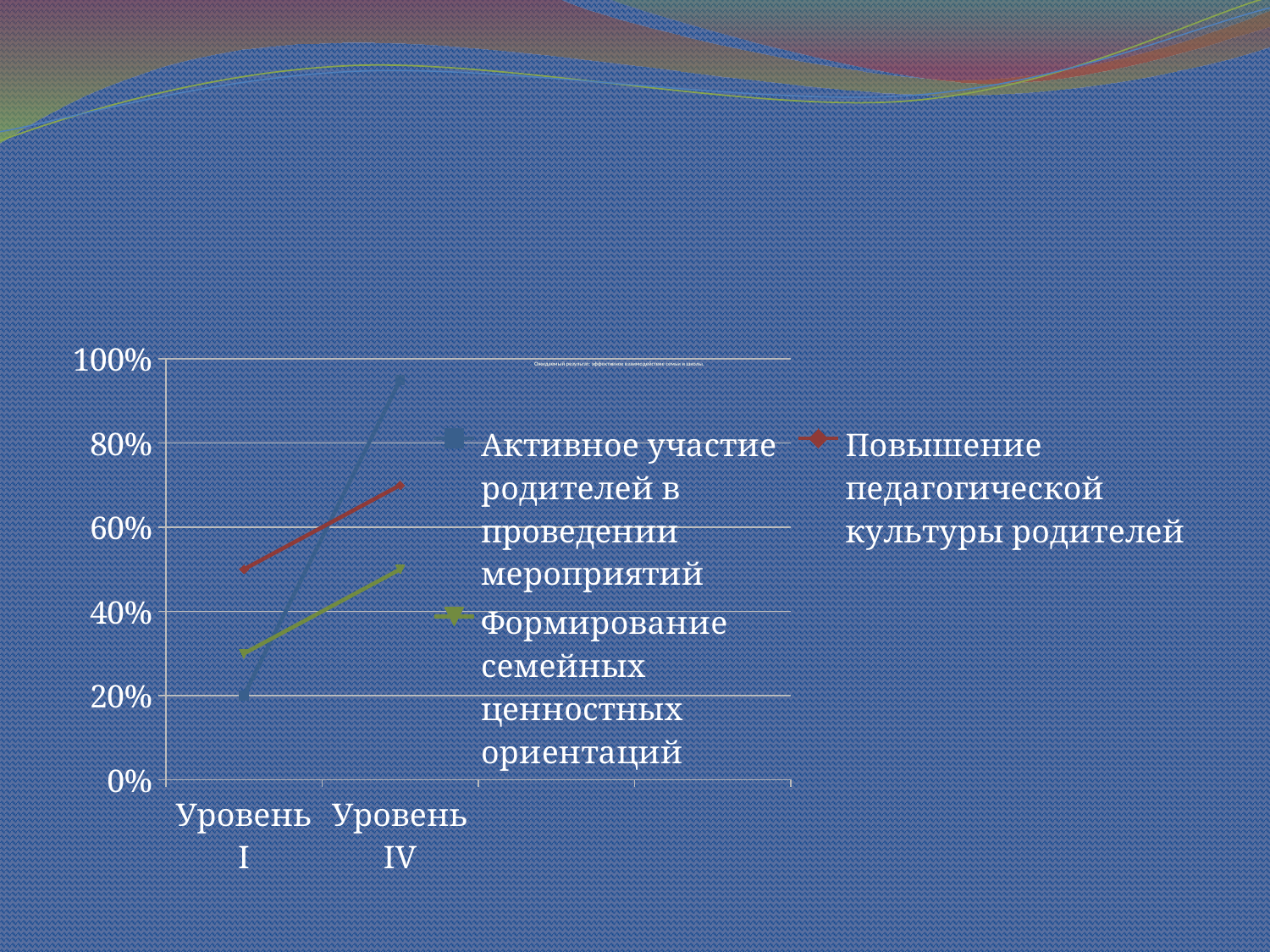
Is the value for Повышение педагогической культуры родителей at Уровень I greater or less than 40%? greater Is the value for Формирование семейных ценностных ориентаций at Уровень I greater or less than 40%? less How many series does the legend list? 3 What kind of chart is shown on the slide? line chart What colour is the line for Повышение педагогической культуры родителей? red How many categories are shown on the x axis? 2 At Уровень I, which is larger: Повышение педагогической культуры родителей or Формирование семейных ценностных ориентаций? Повышение педагогической культуры родителей Is the value for Повышение педагогической культуры родителей at Уровень IV greater or less than 60%? greater Do the values for Активное участие родителей в проведении мероприятий rise or fall from Уровень I to Уровень IV? rise Which series has the highest value at Уровень IV? Активное участие родителей в проведении мероприятий Which series has the lowest value at Уровень I? Активное участие родителей в проведении мероприятий